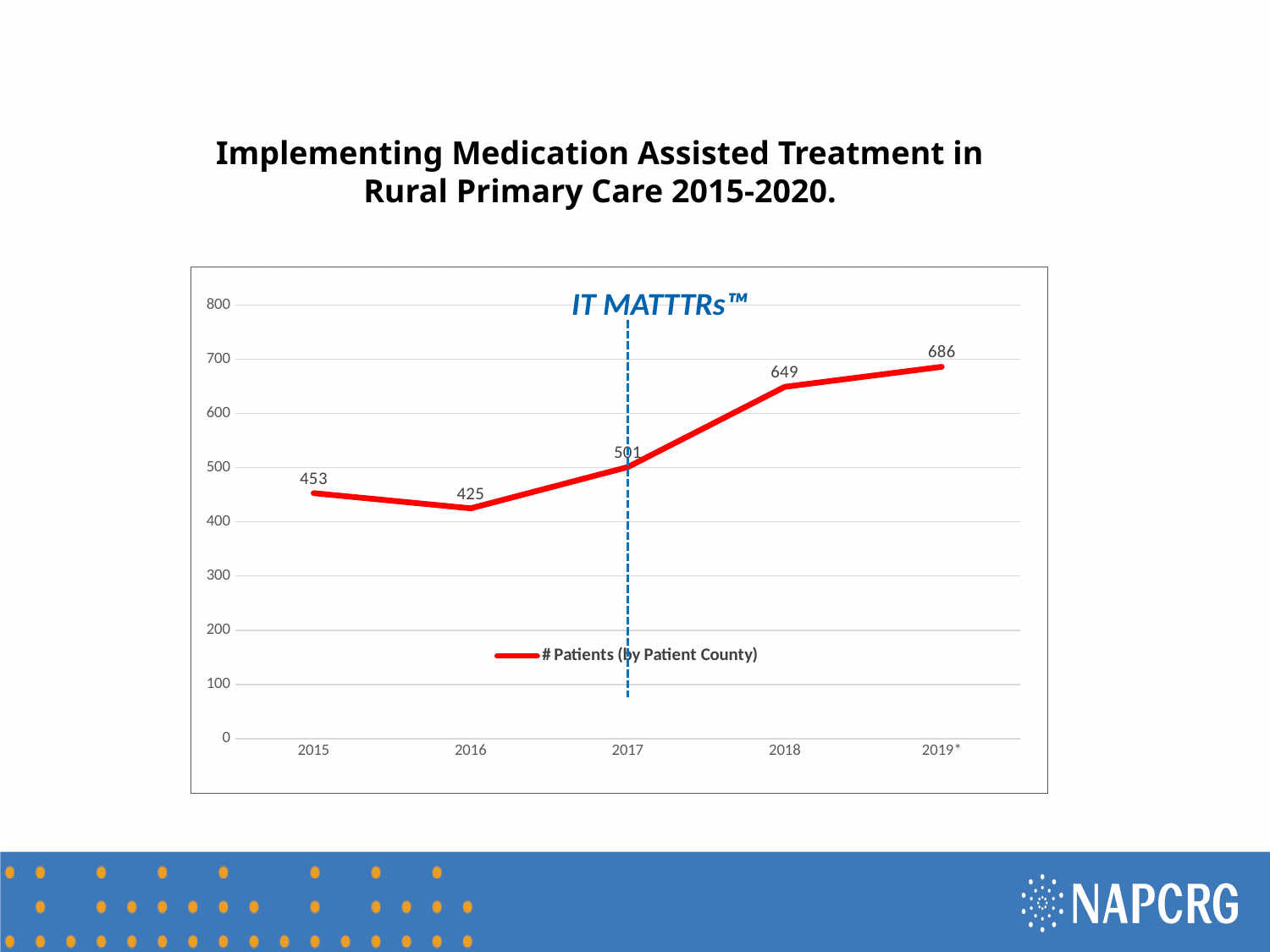
Which year has the lowest number of patients? 2016 What is the number of patients in 2018? 649 What is the number of patients in 2017? 501 What is the number of patients in 2015? 453 What kind of chart is shown on the slide? Line chart Which year has more patients, 2015 or 2016? 2015 What is the legend entry for the red line? # Patients (by Patient County) What is the difference in the number of patients between 2018 and 2017? 148 What is the number of patients in 2016? 425 What is the number of patients in 2019*? 686 How many years are plotted on the x axis? 5 Which year has the highest number of patients? 2019*